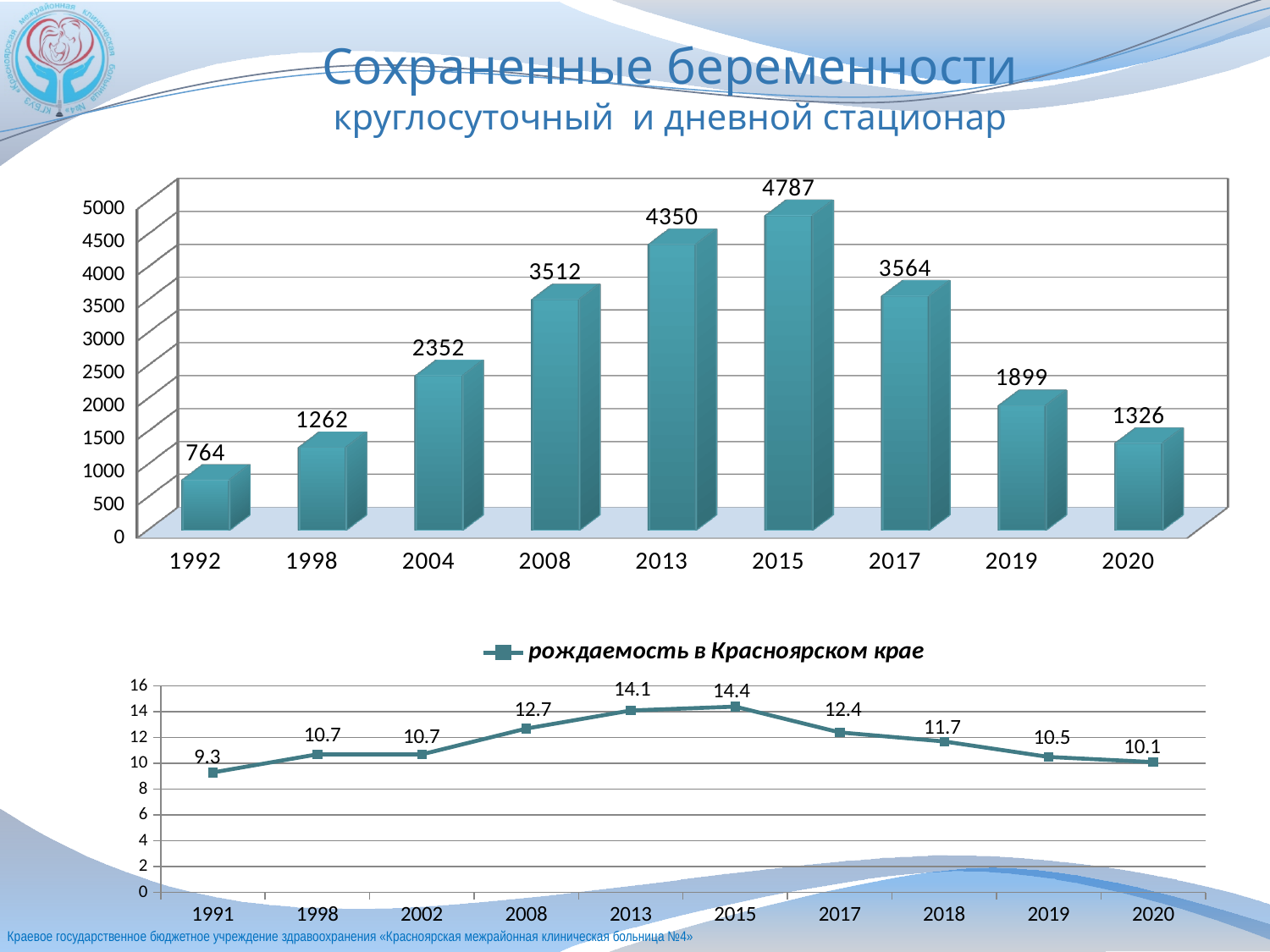
In the bottom chart (рождаемость в Красноярском крае), which year has the highest value? 2015 In the top chart (Сохраненные беременности), which year has the highest value? 2015 In the top chart (Сохраненные беременности), what is the difference between the values for 2015 and 2017? 1223 In the top chart (Сохраненные беременности), what is the value for 2015? 4787 In the top chart (Сохраненные беременности), which year has the lowest value? 1992 In the bottom chart (рождаемость в Красноярском крае), what is the value for 2013? 14.1 In the top chart (Сохраненные беременности), what is the value for 1992? 764 In the bottom chart (рождаемость в Красноярском крае), which is larger, the value for 2017 or the value for 2019? 2017 In the bottom chart (рождаемость в Красноярском крае), how many data points are plotted? 10 In the bottom chart (рождаемость в Красноярском крае), do the values rise or fall from 2015 to 2020? fall What kind of chart is the top chart (Сохраненные беременности)? bar chart In the top chart (Сохраненные беременности), how many years are shown on the x axis? 9